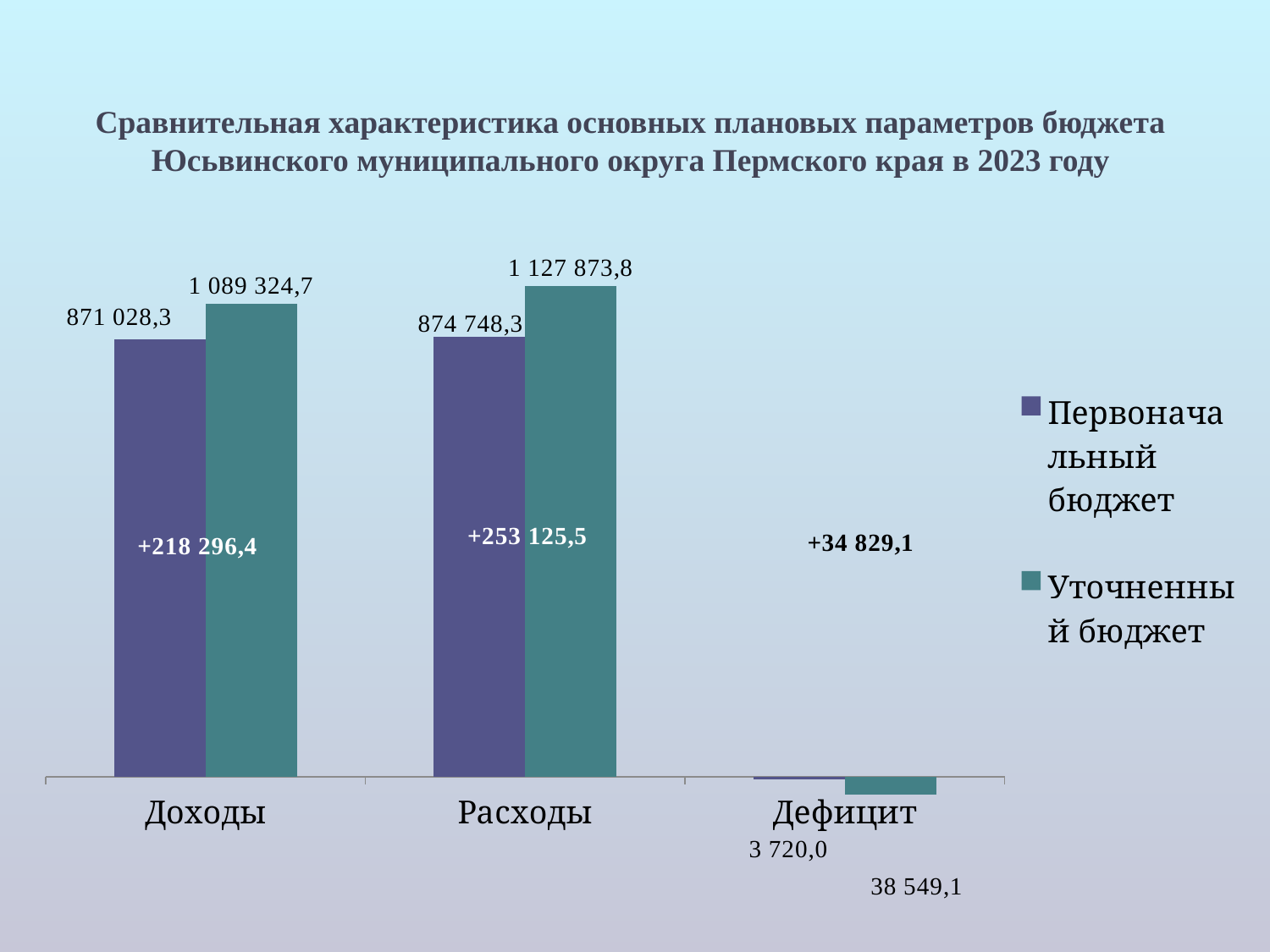
What is the value of Первоначальный бюджет for Дефицит? 3 720,0 What is the value of Первоначальный бюджет for Доходы? 871 028,3 What is the value of Уточненный бюджет for Дефицит? 38 549,1 What kind of chart is shown on the slide? Bar chart Which is larger for Доходы: Первоначальный бюджет or Уточненный бюджет? Уточненный бюджет What is the value of Уточненный бюджет for Доходы? 1 089 324,7 What is the value of Первоначальный бюджет for Расходы? 874 748,3 What is the value of Уточненный бюджет for Расходы? 1 127 873,8 Which category has the lowest value for Первоначальный бюджет? Дефицит Which category has the highest value for Уточненный бюджет? Расходы What is the difference between Уточненный бюджет and Первоначальный бюджет for Расходы, as labelled on the chart? +253 125,5 How many series does the legend list? 2